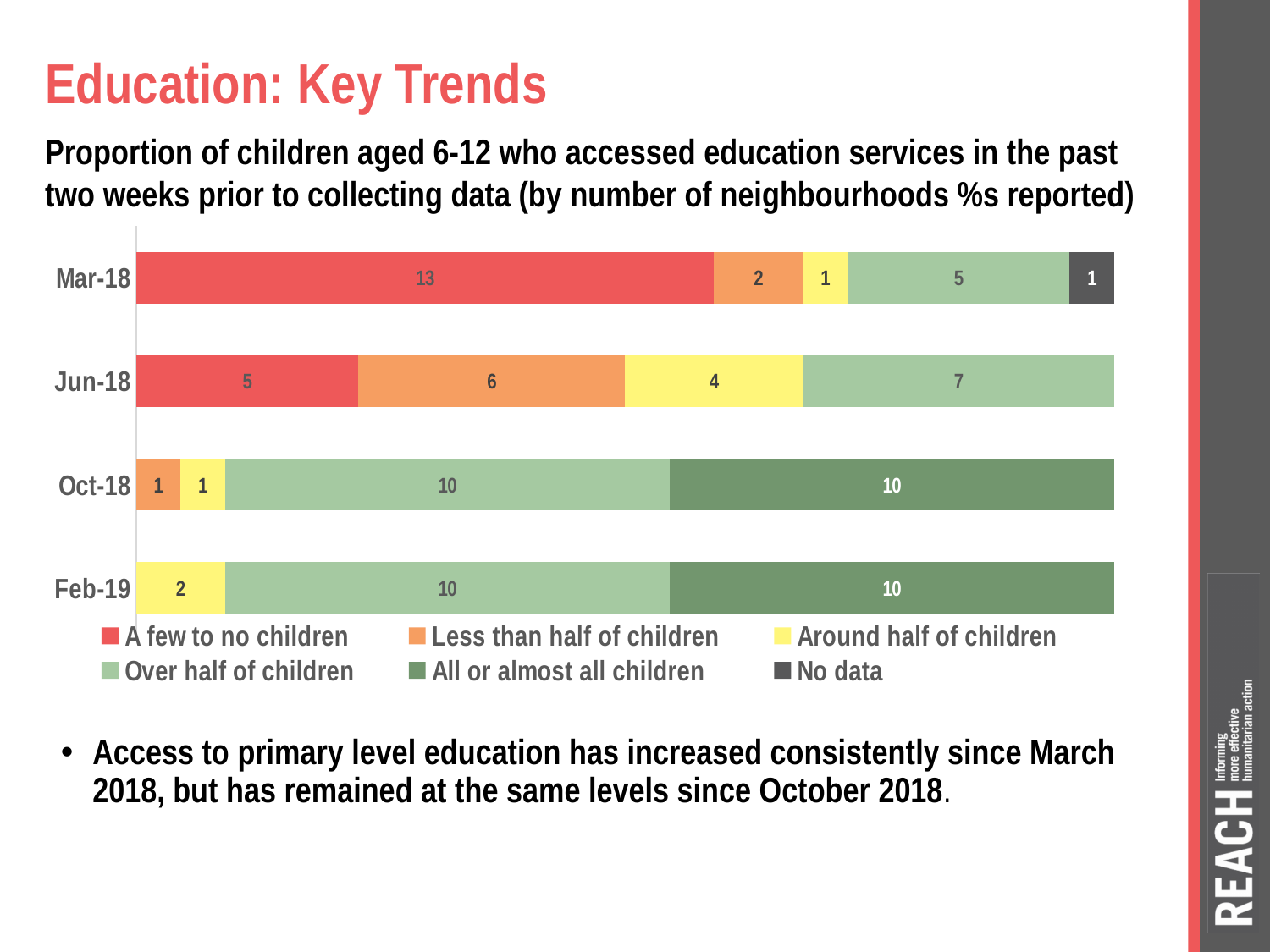
What is the value for 'All or almost all children' in Feb-19? 10 What is the difference between the 'A few to no children' values for Mar-18 and Jun-18? 8 Which period has the highest value for 'A few to no children'? Mar-18 What is the value for 'Around half of children' in Oct-18? 1 What is the total of the stacked bar for Jun-18? 22 What is the value for 'Less than half of children' in Jun-18? 6 How many time periods (categories) are shown on the chart? 4 What is the value for 'A few to no children' in Mar-18? 13 Which period is the only one with a 'No data' segment? Mar-18 Is the 'Over half of children' value larger in Mar-18 or in Oct-18? Oct-18 What type of chart is shown on the slide? Stacked bar chart How many series does the legend list? 6